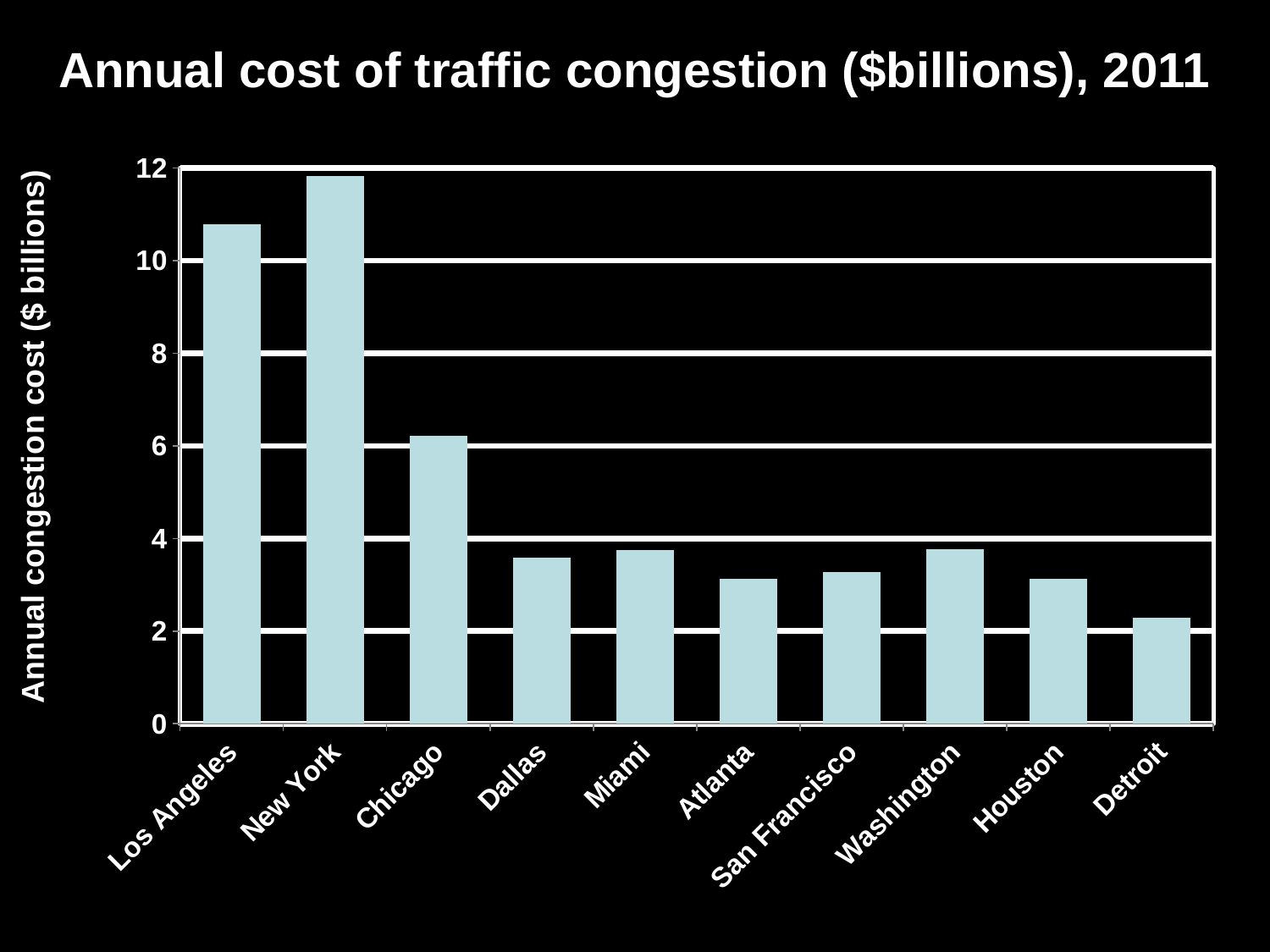
What is the title of the chart? Annual cost of traffic congestion ($billions), 2011 Which city has the highest annual congestion cost? New York What kind of chart is shown on the slide? bar chart Which has a larger annual congestion cost, Chicago or Dallas? Chicago Is the value for Dallas greater or less than 4? less Is the value for New York greater or less than 12? less Which city has the lowest annual congestion cost? Detroit Is the value for Chicago greater or less than 6? greater Which has a larger annual congestion cost, Houston or Detroit? Houston How many cities are shown on the chart? 10